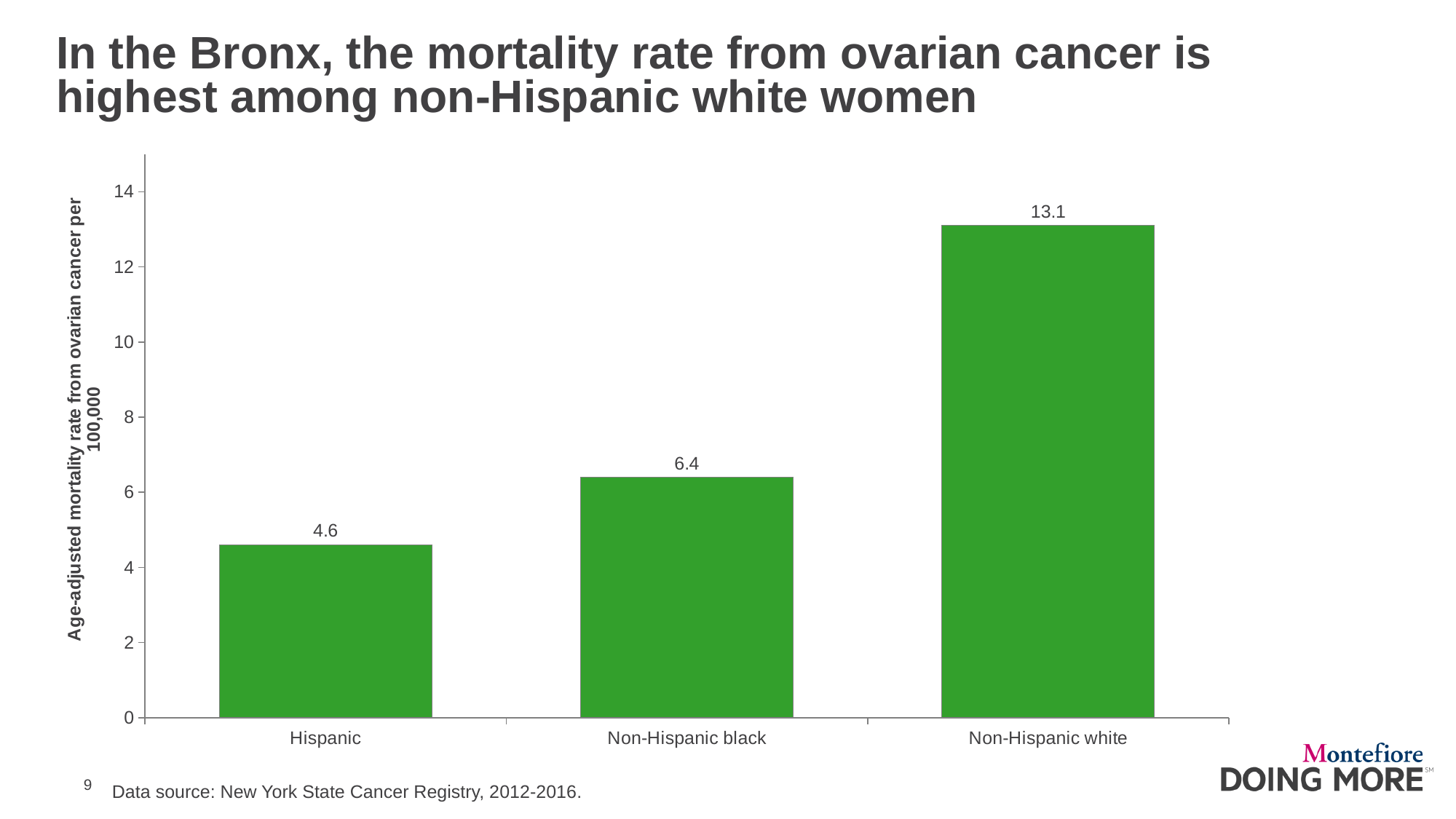
Is the mortality rate for non-Hispanic white women greater or less than 12? greater What is the difference between the mortality rates for non-Hispanic black and Hispanic women? 1.8 Which is larger, the mortality rate for non-Hispanic black women or for Hispanic women? Non-Hispanic black Which group has the highest ovarian cancer mortality rate? Non-Hispanic white What is the age-adjusted mortality rate from ovarian cancer for non-Hispanic white women? 13.1 Which group has the lowest ovarian cancer mortality rate? Hispanic What is the age-adjusted mortality rate from ovarian cancer for non-Hispanic black women? 6.4 How many groups are shown on the chart? 3 What is the difference between the mortality rates for non-Hispanic white and Hispanic women? 8.5 What kind of chart is shown on the slide? Bar chart What is the age-adjusted mortality rate from ovarian cancer for Hispanic women? 4.6 What is the label of the vertical axis? Age-adjusted mortality rate from ovarian cancer per 100,000